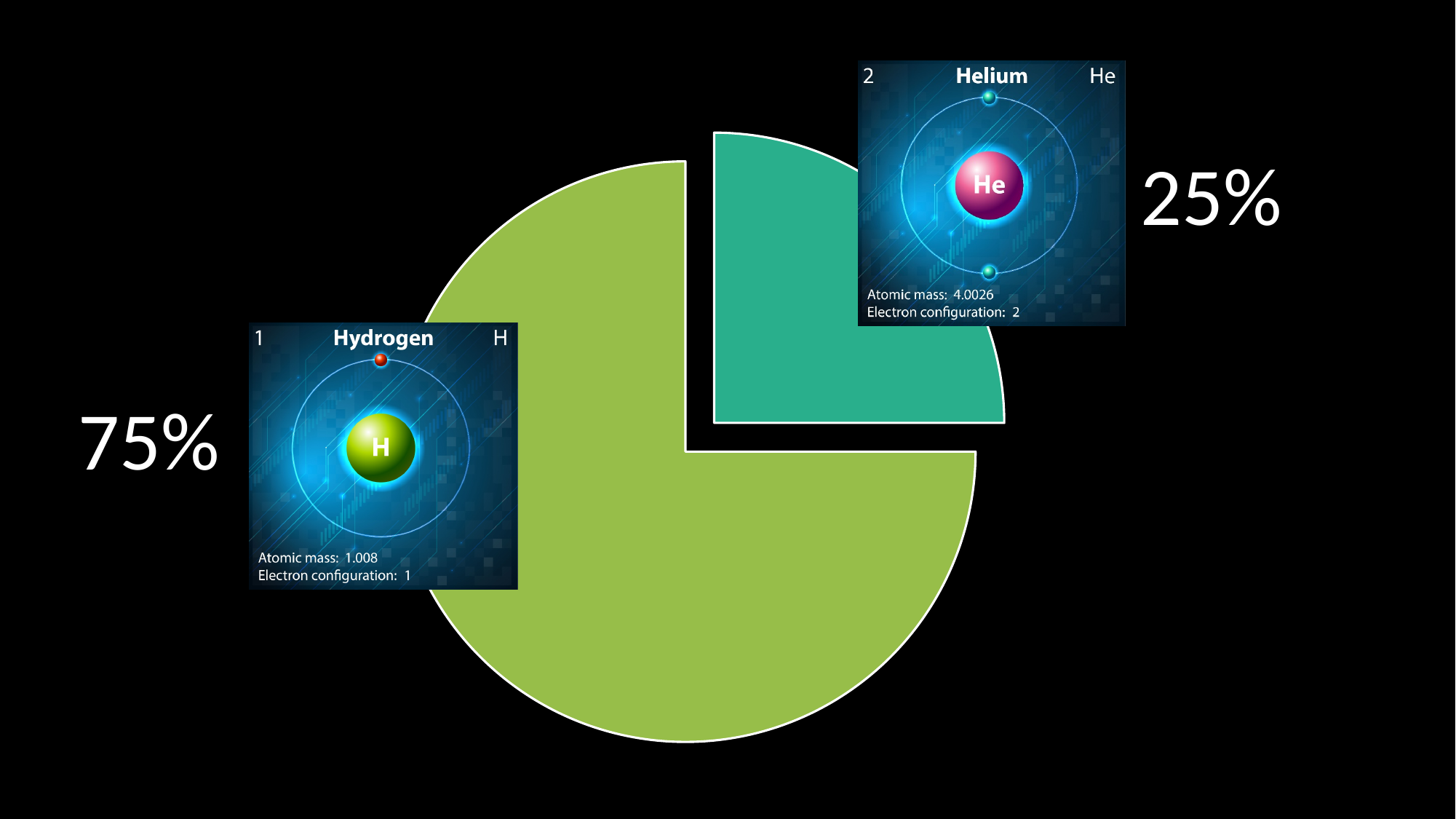
Which is larger, the Hydrogen slice or the Helium slice? Hydrogen What kind of chart is shown on the slide? pie chart What colour is the Hydrogen slice of the pie chart? green What is the total of the two slice percentages shown on the pie chart? 100% How many slices does the pie chart have? 2 What is the difference in percentage points between the Hydrogen slice and the Helium slice? 50 What share of the pie does the Hydrogen slice represent? 75% What colour is the Helium slice of the pie chart? teal What share of the pie does the Helium slice represent? 25% Which slice of the pie chart is the smallest? Helium Which slice of the pie chart is the largest? Hydrogen